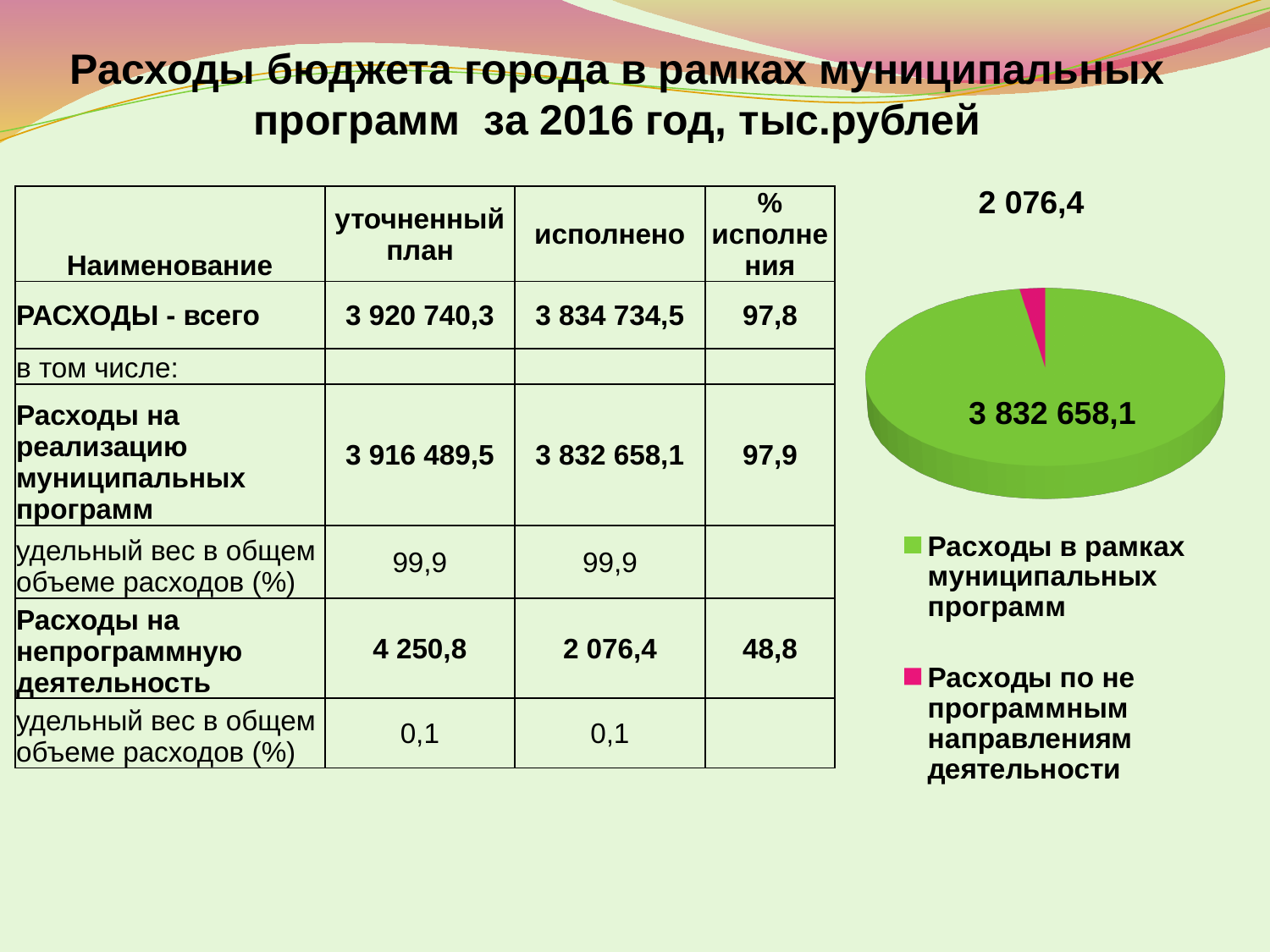
What is the total of the two slice values in the pie chart? 3 834 734,5 Which slice of the pie chart is the largest? Расходы в рамках муниципальных программ How many slices does the pie chart have? 2 What is the difference between the two slice values in the pie chart? 3 830 581,7 What colour is the slice for Расходы по не программным направлениям деятельности in the pie chart? pink What is the value of the slice for Расходы в рамках муниципальных программ in the pie chart? 3 832 658,1 What colour is the slice for Расходы в рамках муниципальных программ in the pie chart? green What is the value of the slice for Расходы по не программным направлениям деятельности in the pie chart? 2 076,4 In the pie chart, which is larger: Расходы в рамках муниципальных программ or Расходы по не программным направлениям деятельности? Расходы в рамках муниципальных программ How many entries does the pie chart legend list? 2 Which slice of the pie chart is the smallest? Расходы по не программным направлениям деятельности What kind of chart is shown on the slide? pie chart